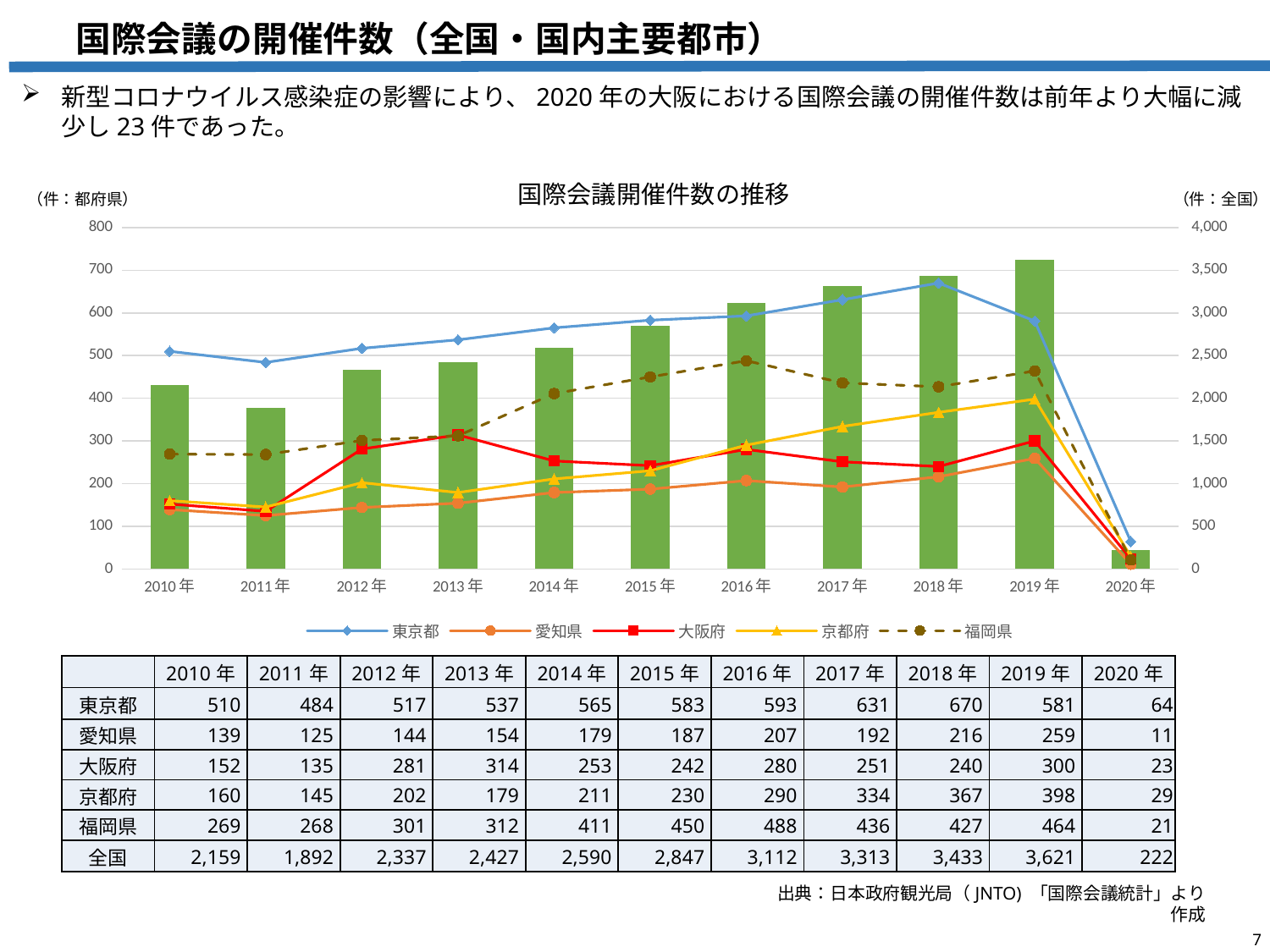
According to the table, what was the number of international conferences held in 大阪府 in 2020年? 23 How did the 全国 bars change from 2011年 to 2019年? They rose every year Which prefecture had the highest number of international conferences in 2019年? 東京都 According to the table, what was the value for 全国 in 2019年? 3,621 What is the title of the chart? 国際会議開催件数の推移 What is the difference between the 全国 values for 2019年 and 2020年? 3,399 How many years are shown along the x axis of the chart? 11 In 2016年, which was larger: the value for 京都府 or the value for 大阪府? 京都府 How many series does the chart legend list? 5 Is the value for 福岡県 in 2016年 greater or less than 400? greater According to the table, what was the value for 東京都 in 2018年? 670 Which prefecture had the lowest number of international conferences in 2020年? 愛知県